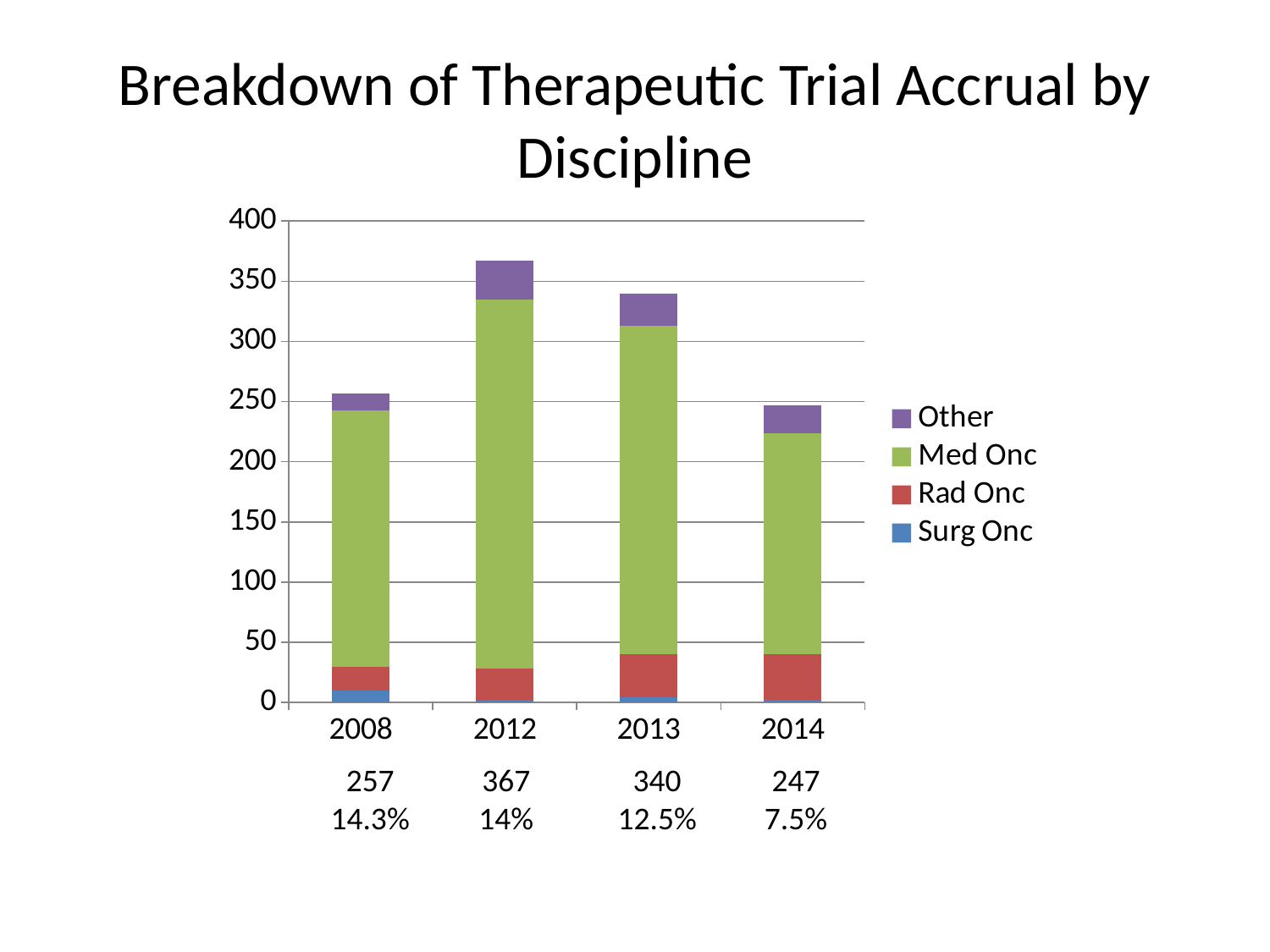
Which series is shown in green in the legend? Med Onc What percentage is printed below the 2013 bar? 12.5% Which year has the lowest total accrual? 2014 What is the total therapeutic trial accrual shown for 2012? 367 What kind of chart is shown on the slide? Stacked bar chart How many years are shown on the x axis? 4 Is the total accrual for 2013 greater or less than 300? greater Which year has the highest total accrual? 2012 What is the difference between the total accrual in 2012 and in 2008? 110 How many series does the legend list? 4 What percentage is printed below the 2008 bar? 14.3% What is the total therapeutic trial accrual shown for 2014? 247